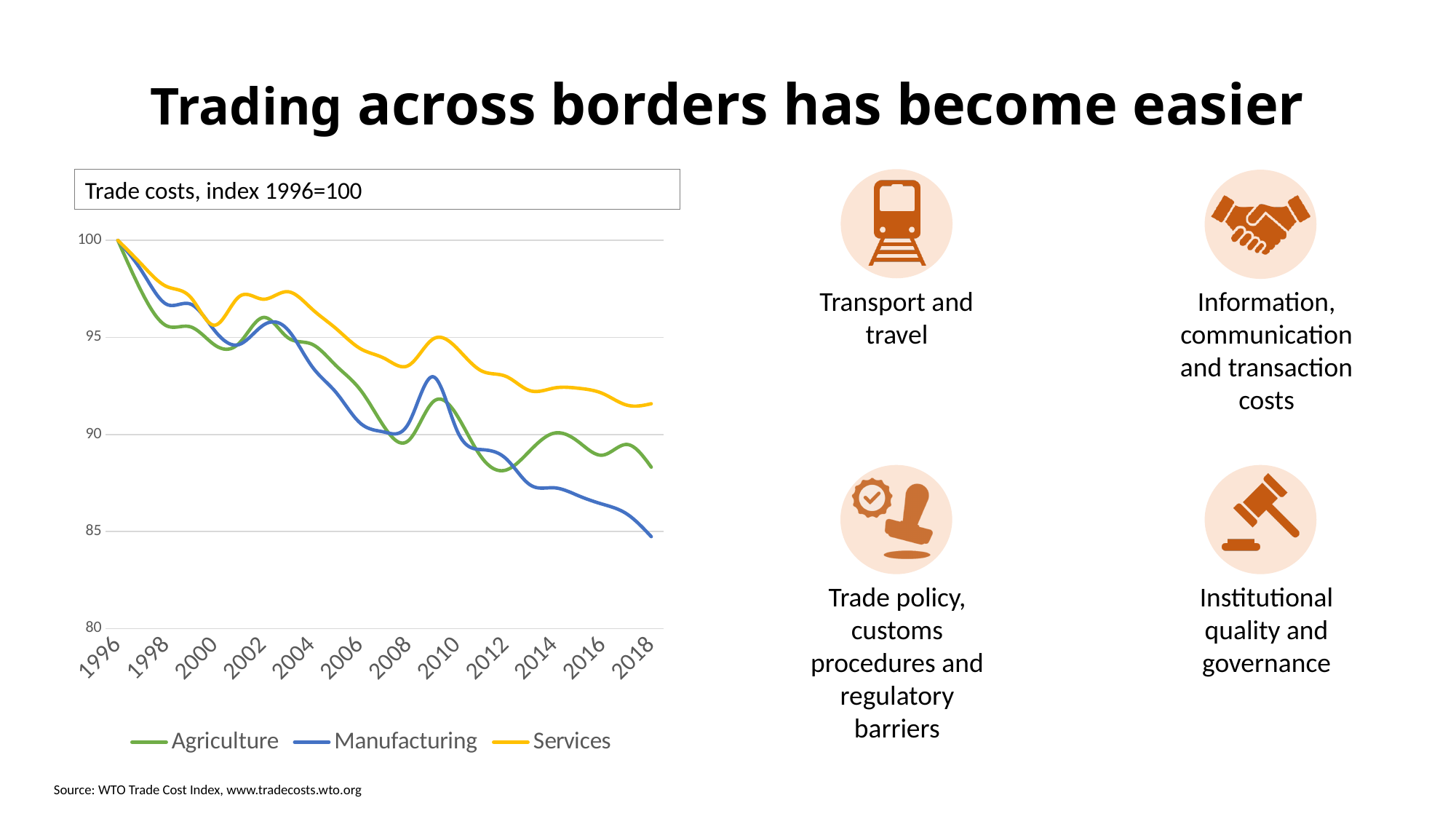
Is the value for Services in 2018 greater or less than 90? greater Which series has the lowest value in 2018? Manufacturing In 2018, which is larger: the value for Agriculture or the value for Manufacturing? Agriculture Is the value for Manufacturing in 2018 greater or less than 85? less What is the value of the Services series in 1996? 100 Is the value for Agriculture in 2018 greater or less than 90? less How many series does the chart's legend list? 3 Do the values of the Services series rise or fall from 1996 to 2018? fall What kind of chart is shown on the slide? line chart What is the title of the chart? Trade costs, index 1996=100 Which series has the highest value in 2018? Services What is the value of the Manufacturing series in 1996? 100